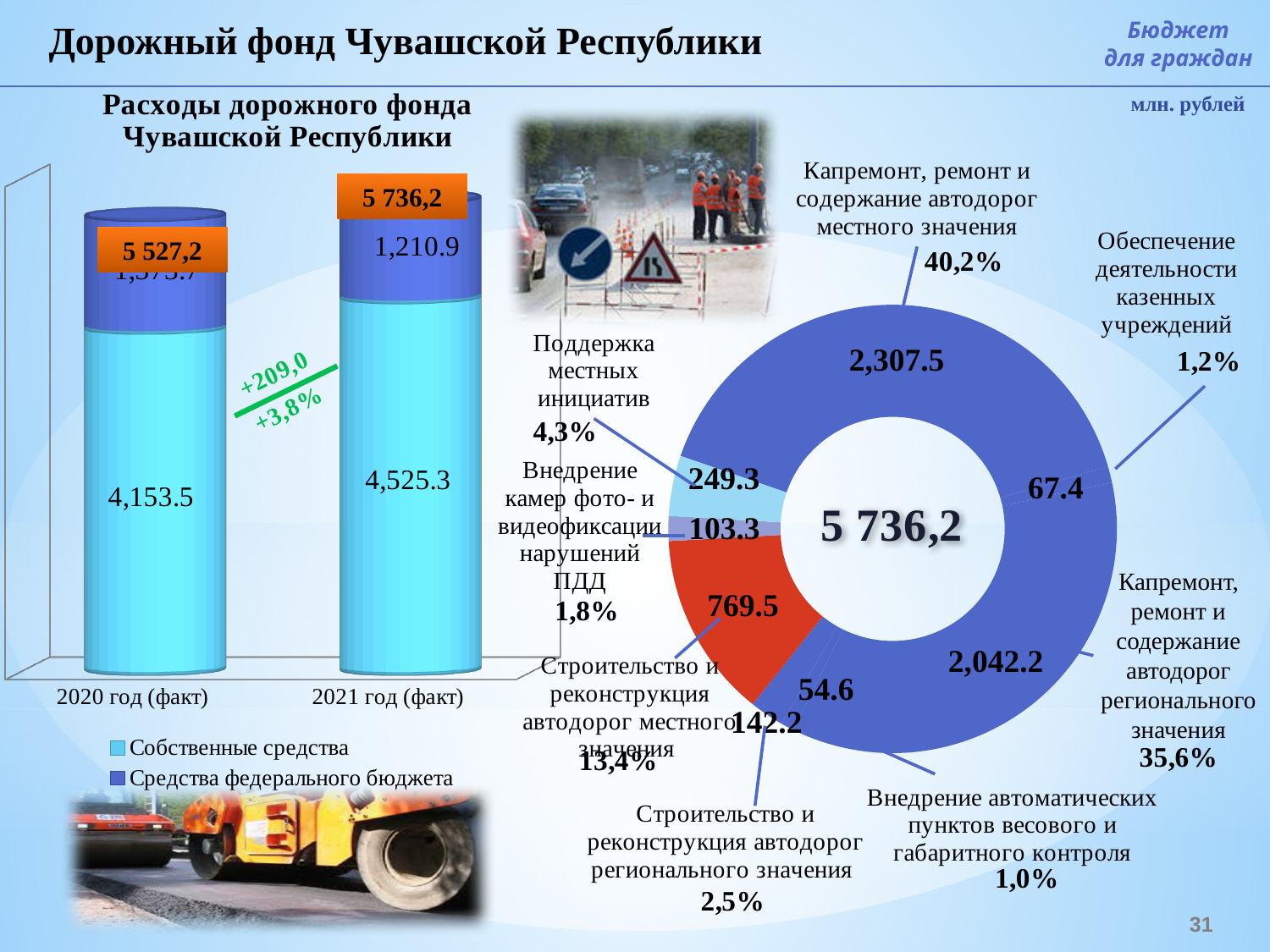
On the bar chart 'Расходы дорожного фонда Чувашской Республики', what is the value of Средства федерального бюджета for 2021 год (факт)? 1,210.9 What kind of chart is the chart on the left of the slide? bar chart On the bar chart 'Расходы дорожного фонда Чувашской Республики', what is the difference in Собственные средства between 2021 and 2020? 371.8 On the bar chart 'Расходы дорожного фонда Чувашской Республики', what is the value of Собственные средства for 2021 год (факт)? 4,525.3 On the bar chart 'Расходы дорожного фонда Чувашской Республики', how many series does the legend list? 2 On the doughnut chart on the right, which category has the smallest value? Внедрение автоматических пунктов весового и габаритного контроля On the doughnut chart on the right, what is the value for 'Капремонт, ремонт и содержание автодорог местного значения'? 2,307.5 On the bar chart 'Расходы дорожного фонда Чувашской Республики', which year has the larger value of Собственные средства, 2020 or 2021? 2021 год (факт) On the doughnut chart on the right, how many segments are there? 8 On the bar chart 'Расходы дорожного фонда Чувашской Республики', what is the total for 2020 год (факт)? 5 527,2 On the doughnut chart on the right, what share does 'Капремонт, ремонт и содержание автодорог регионального значения' have? 35,6% On the doughnut chart on the right, what is the total shown in the centre? 5 736,2